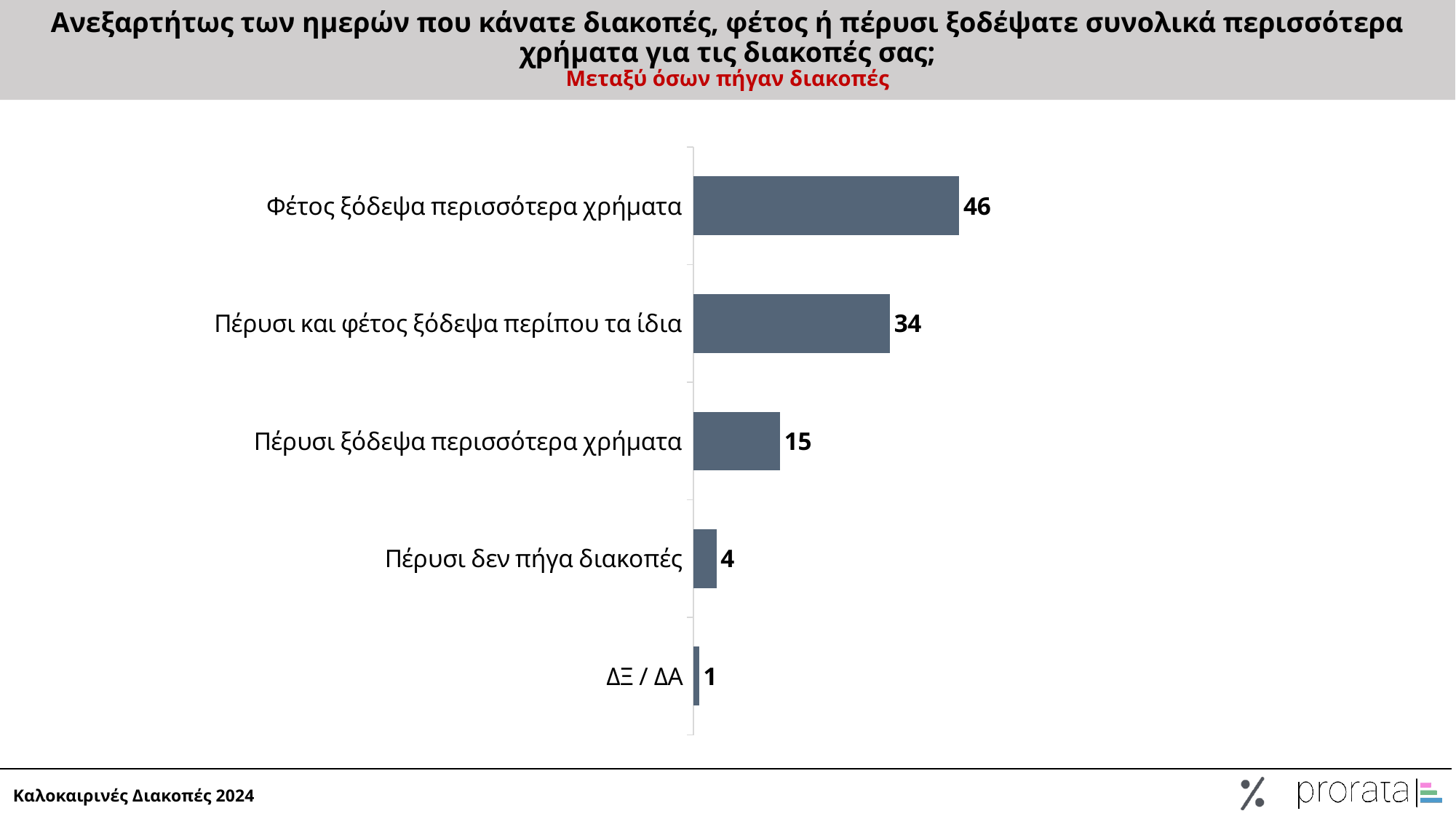
What is the value for "Πέρυσι και φέτος ξόδεψα περίπου τα ίδια"? 34 What is the value for "Πέρυσι ξόδεψα περισσότερα χρήματα"? 15 What is the value for "Φέτος ξόδεψα περισσότερα χρήματα"? 46 What is the value for "Πέρυσι δεν πήγα διακοπές"? 4 How many categories are shown in the chart? 5 Which is larger: the value for "Πέρυσι και φέτος ξόδεψα περίπου τα ίδια" or the value for "Πέρυσι ξόδεψα περισσότερα χρήματα"? Πέρυσι και φέτος ξόδεψα περίπου τα ίδια Which category has the lowest value? ΔΞ / ΔΑ What kind of chart is shown on the slide? Bar chart What is the difference between the values for "Φέτος ξόδεψα περισσότερα χρήματα" and "Πέρυσι και φέτος ξόδεψα περίπου τα ίδια"? 12 Which category has the highest value? Φέτος ξόδεψα περισσότερα χρήματα What is the value for "ΔΞ / ΔΑ"? 1 What is the difference between the values for "Πέρυσι ξόδεψα περισσότερα χρήματα" and "Πέρυσι δεν πήγα διακοπές"? 11